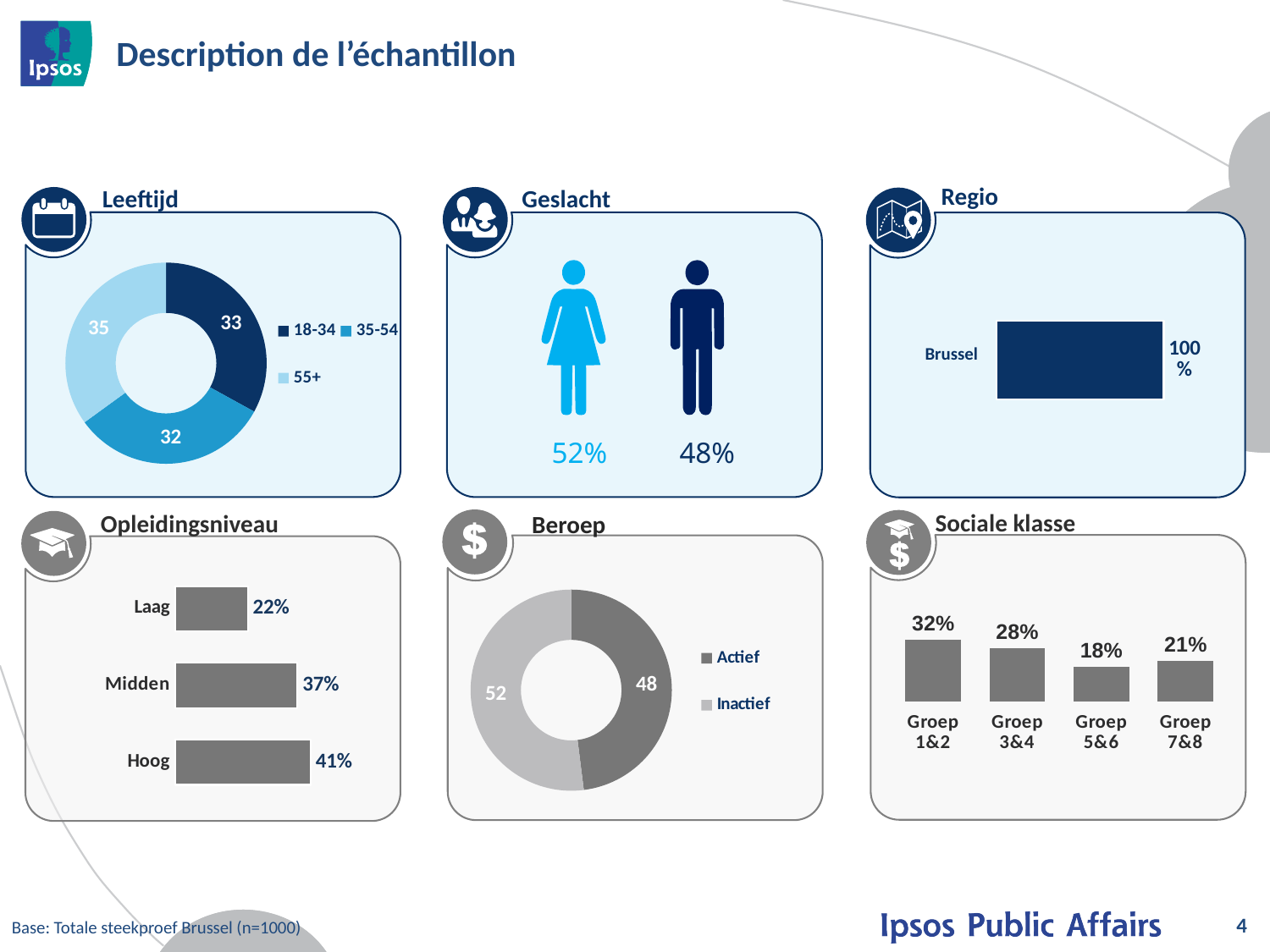
In the Opleidingsniveau chart, which category has the highest value? Hoog In the Leeftijd chart, which age group has the lowest value? 35-54 In the Beroep chart, which is larger, Actief or Inactief? Inactief In the Beroep chart, what is the value for Inactief? 52 In the Opleidingsniveau chart, what is the value for Midden? 37% What kind of chart is the Leeftijd chart? Donut chart In the Sociale klasse chart, what is the value for Groep 5&6? 18% In the Opleidingsniveau chart, what is the difference between Hoog and Laag? 19% In the Regio chart, what is the value for Brussel? 100% In the Leeftijd chart, what is the value for the 55+ segment? 35 How many categories are shown in the Sociale klasse chart? 4 How many series does the legend of the Leeftijd chart list? 3